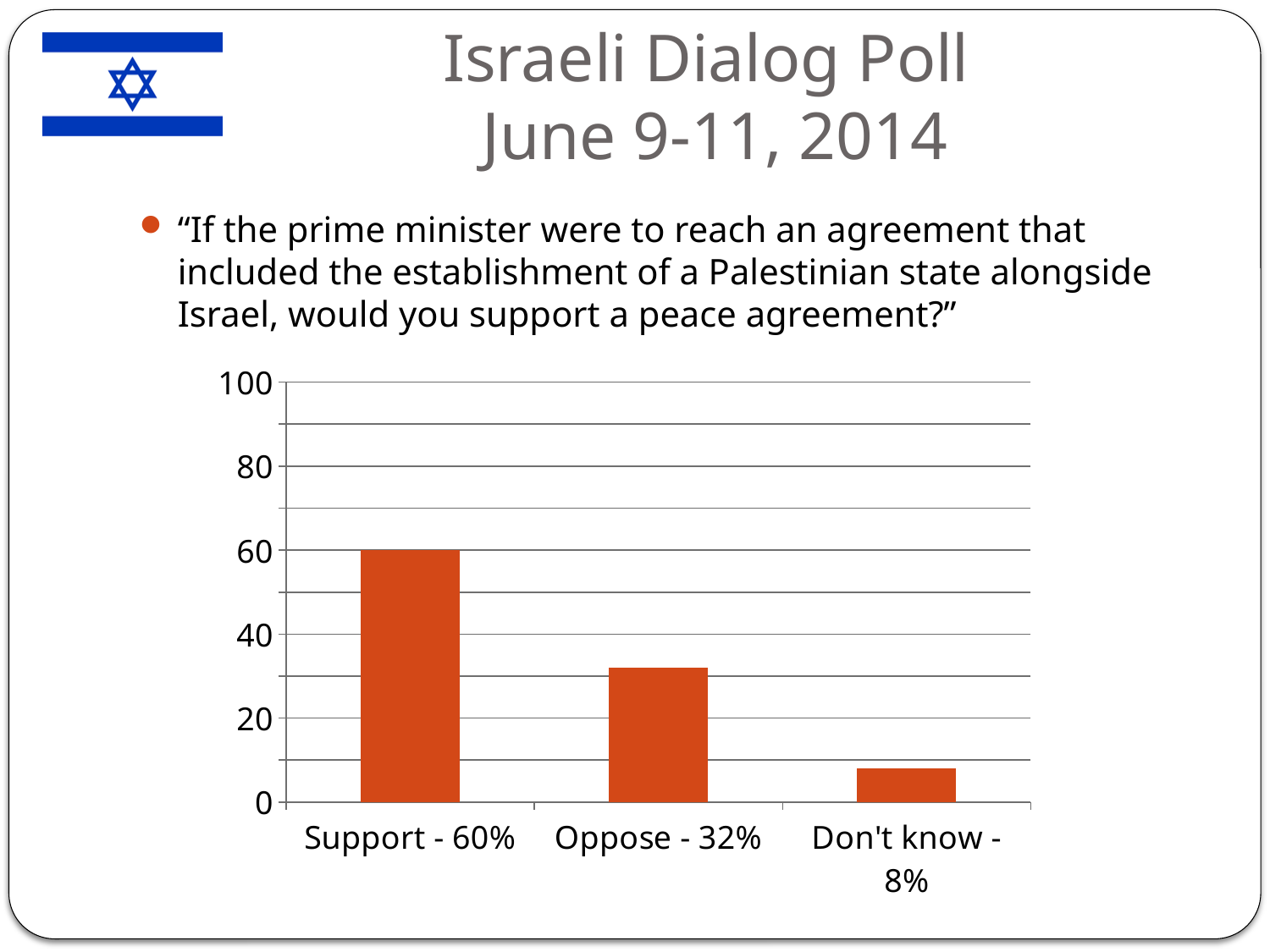
What percentage of respondents said they would oppose a peace agreement? 32% What is the difference between the Oppose and Don't know percentages? 24% What percentage of respondents said they would support a peace agreement? 60% Which response category has the highest value? Support Which response category has the lowest value? Don't know What is the difference between the Support and Oppose percentages? 28% What kind of chart is shown on the slide? Bar chart How many response categories are shown in the chart? 3 What percentage of respondents answered "Don't know"? 8% Which is larger, the value for Support or the value for Oppose? Support Do the bar values rise or fall from left to right across the categories? Fall Is the value for Oppose greater or less than 40? less